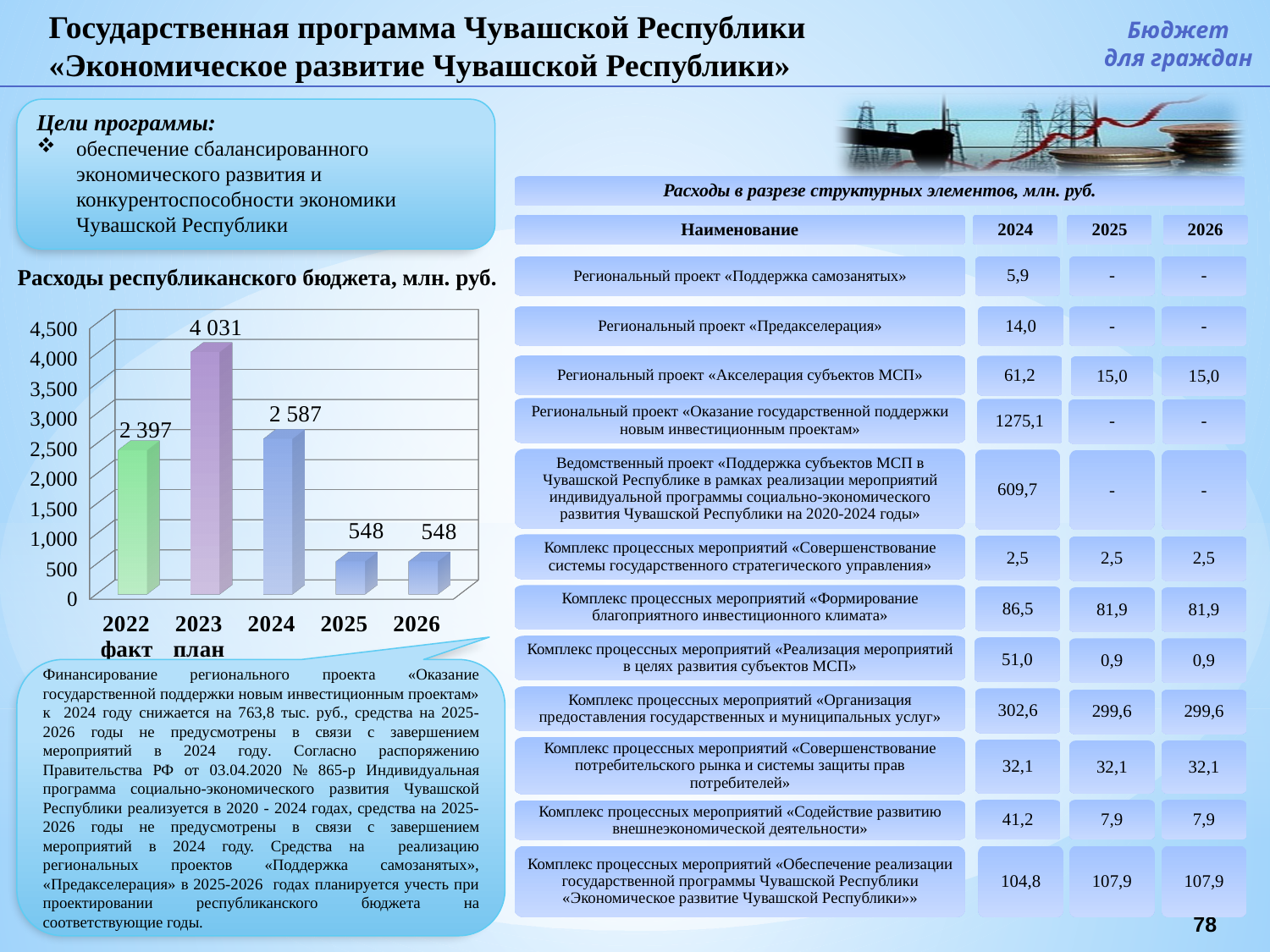
What is the difference between the values for 2024 and 2022 in the chart? 190 What kind of chart is shown on the slide? bar chart What is the value for 2023 in the chart 'Расходы республиканского бюджета, млн. руб.'? 4 031 What is the value for 2024 in the chart? 2 587 What is the value for 2026 in the chart? 548 Which year has the highest value in the chart? 2023 What is the difference between the values for 2023 and 2024 in the chart? 1 444 Is the value for 2025 in the chart greater or less than 1,000? less What is the value for 2022 in the chart? 2 397 What is the title of the chart on the slide? Расходы республиканского бюджета, млн. руб. Which is larger in the chart, the value for 2022 or the value for 2024? 2024 How many years are shown on the x axis of the chart? 5